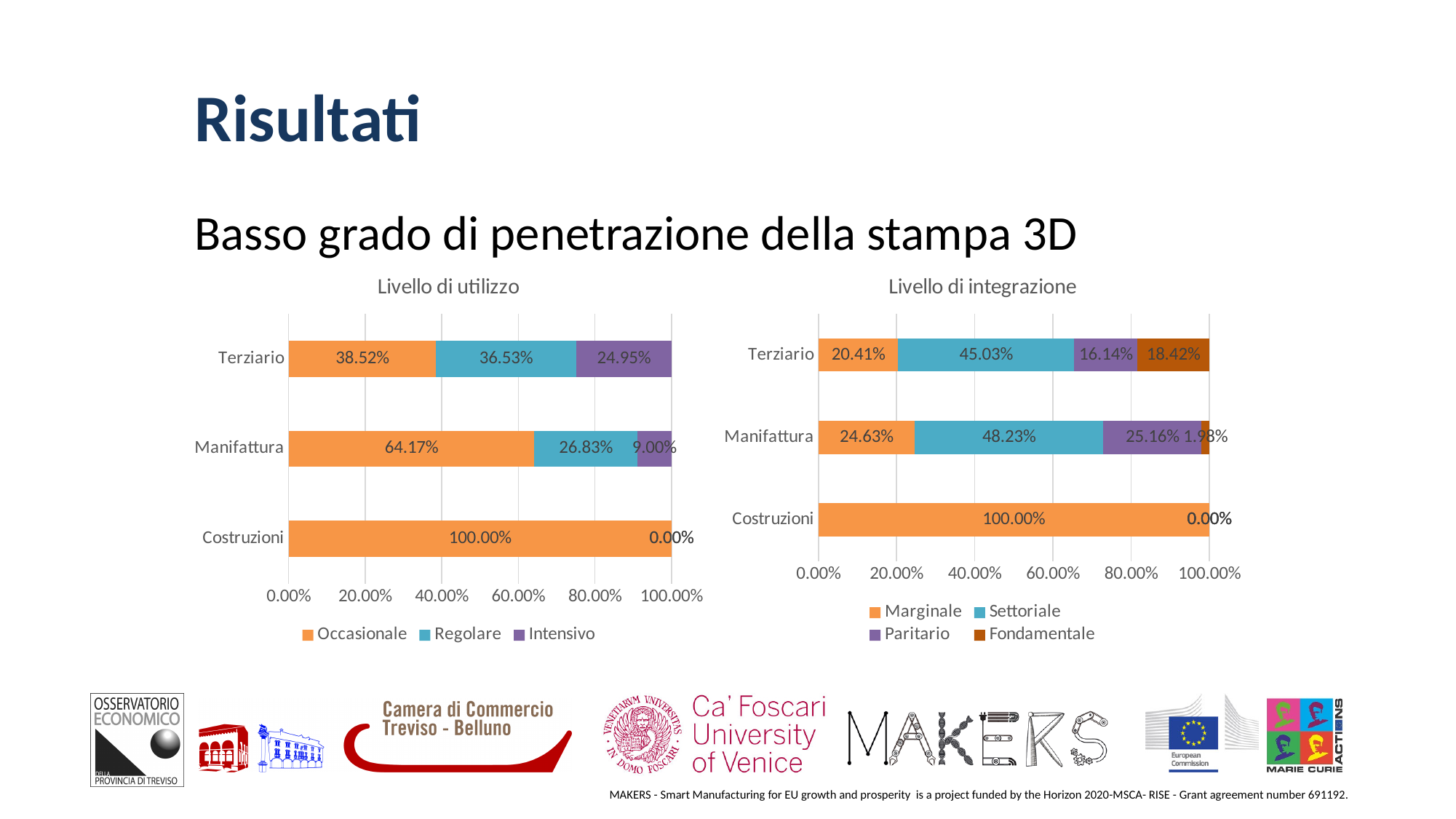
In the 'Livello di integrazione' chart, what is the Fondamentale value for Terziario? 18.42% In the 'Livello di integrazione' chart, what is the Settoriale value for Manifattura? 48.23% In the 'Livello di utilizzo' chart, what is the Occasionale value for Terziario? 38.52% In the 'Livello di utilizzo' chart, which category has the lowest Intensivo value? Costruzioni In the 'Livello di utilizzo' chart, what is the difference between the Occasionale values for Manifattura and Terziario? 25.65% In the 'Livello di integrazione' chart, how many series does the legend list? 4 In the 'Livello di utilizzo' chart, which category has the highest Occasionale value? Costruzioni What kind of chart is the 'Livello di integrazione' chart? Stacked bar chart In the 'Livello di utilizzo' chart, what is the Regolare value for Manifattura? 26.83% In the 'Livello di integrazione' chart, which is larger for Terziario: the Paritario value or the Fondamentale value? Fondamentale In the 'Livello di utilizzo' chart, how many categories are shown on the vertical axis? 3 In the 'Livello di utilizzo' chart, which series is shown in purple? Intensivo